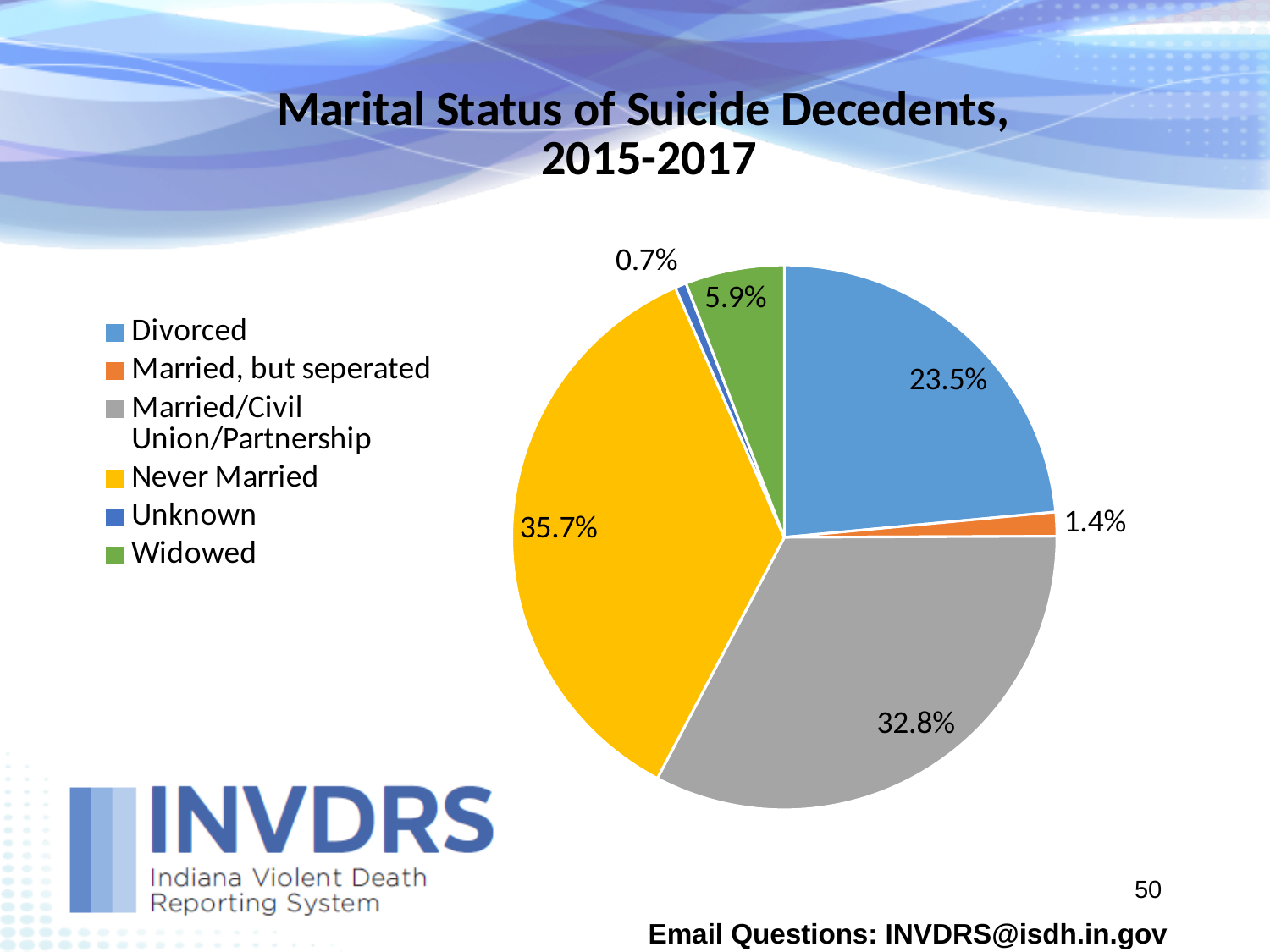
What share of suicide decedents had an Unknown marital status? 0.7% What share of suicide decedents were Widowed? 5.9% What is the difference in percentage points between the Never Married and Divorced shares? 12.2 What share of suicide decedents were Married/Civil Union/Partnership? 32.8% What is the title of the chart? Marital Status of Suicide Decedents, 2015-2017 Which marital status category has the largest share of the pie? Never Married How many marital status categories are shown in the pie chart? 6 What type of chart is shown on the slide? Pie chart What share of suicide decedents were Never Married? 35.7% What share of suicide decedents were Divorced? 23.5% Which is larger, the share for Widowed or the share for Married, but seperated? Widowed Which marital status category has the smallest share of the pie? Unknown